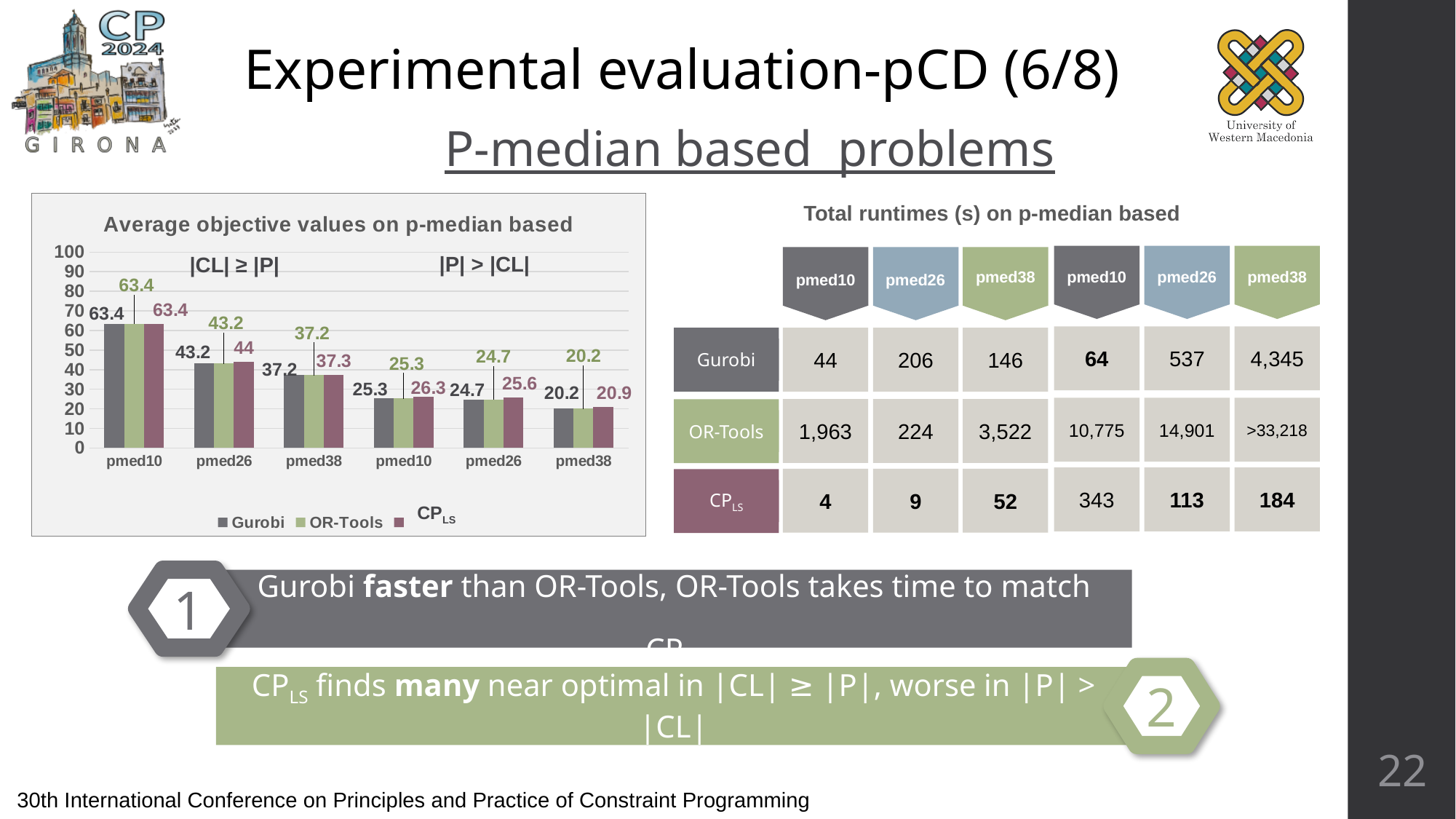
In the "Average objective values on p-median based" chart, for pmed26 in the |P| > |CL| group, which is larger: the CP_LS value or the Gurobi value? CP_LS In the "Average objective values on p-median based" chart, what is the difference between the CP_LS and Gurobi values for pmed10 in the |P| > |CL| group? 1 In the "Average objective values on p-median based" chart, what is the CP_LS value for pmed26 in the |CL| ≥ |P| group? 44 In the "Average objective values on p-median based" chart, which category has the highest Gurobi value? pmed10 in the |CL| ≥ |P| group How many series does the legend of the "Average objective values on p-median based" chart list? 3 In the "Average objective values on p-median based" chart, what is the OR-Tools value for pmed10 in the |CL| ≥ |P| group? 63.4 In the "Average objective values on p-median based" chart, what is the CP_LS value for pmed38 in the |P| > |CL| group? 20.9 In the "Average objective values on p-median based" chart, what is the Gurobi value for pmed38 in the |P| > |CL| group? 20.2 What kind of chart is "Average objective values on p-median based"? bar chart In the "Average objective values on p-median based" chart, which category has the lowest Gurobi value? pmed38 in the |P| > |CL| group How many categories are shown along the x axis of the "Average objective values on p-median based" chart? 6 In the "Average objective values on p-median based" chart, do the Gurobi values rise or fall from left to right along the x axis? fall